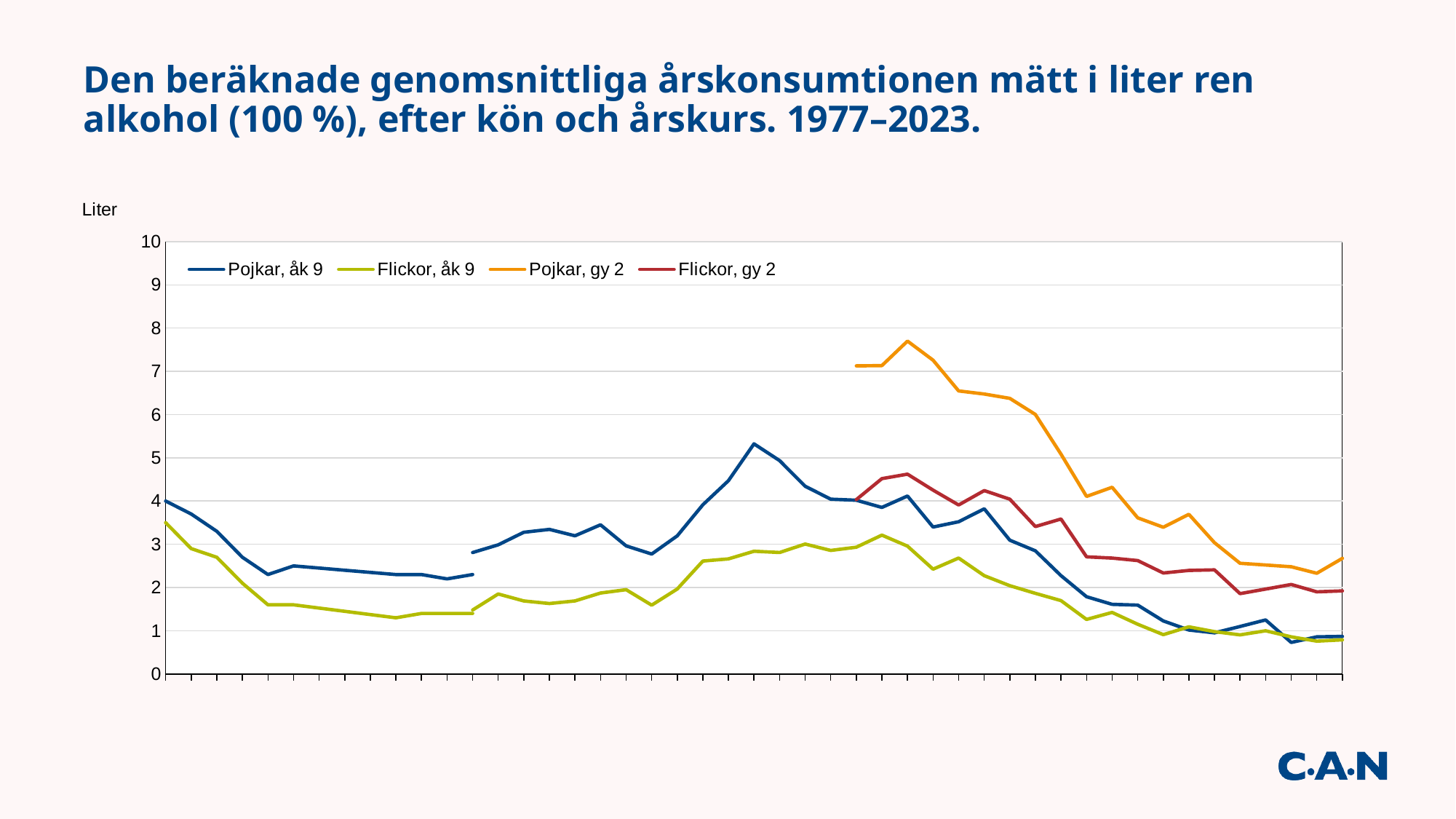
Is the value of the Pojkar, gy 2 series at its first plotted point greater or less than 7? greater Is the highest value of the Flickor, åk 9 series greater or less than 4? less What is the label on the vertical axis of the chart? Liter Do the values of the Pojkar, gy 2 series generally rise or fall from its first point to its last point? fall What kind of chart is shown on the slide? line chart What is the highest value shown on the vertical axis? 10 Over the most recent years on the chart, which series is higher: Pojkar, gy 2 or Pojkar, åk 9? Pojkar, gy 2 Is the peak value of the Pojkar, åk 9 series greater or less than 5? greater Which series reaches the highest value anywhere on the chart? Pojkar, gy 2 How many series does the legend list? 4